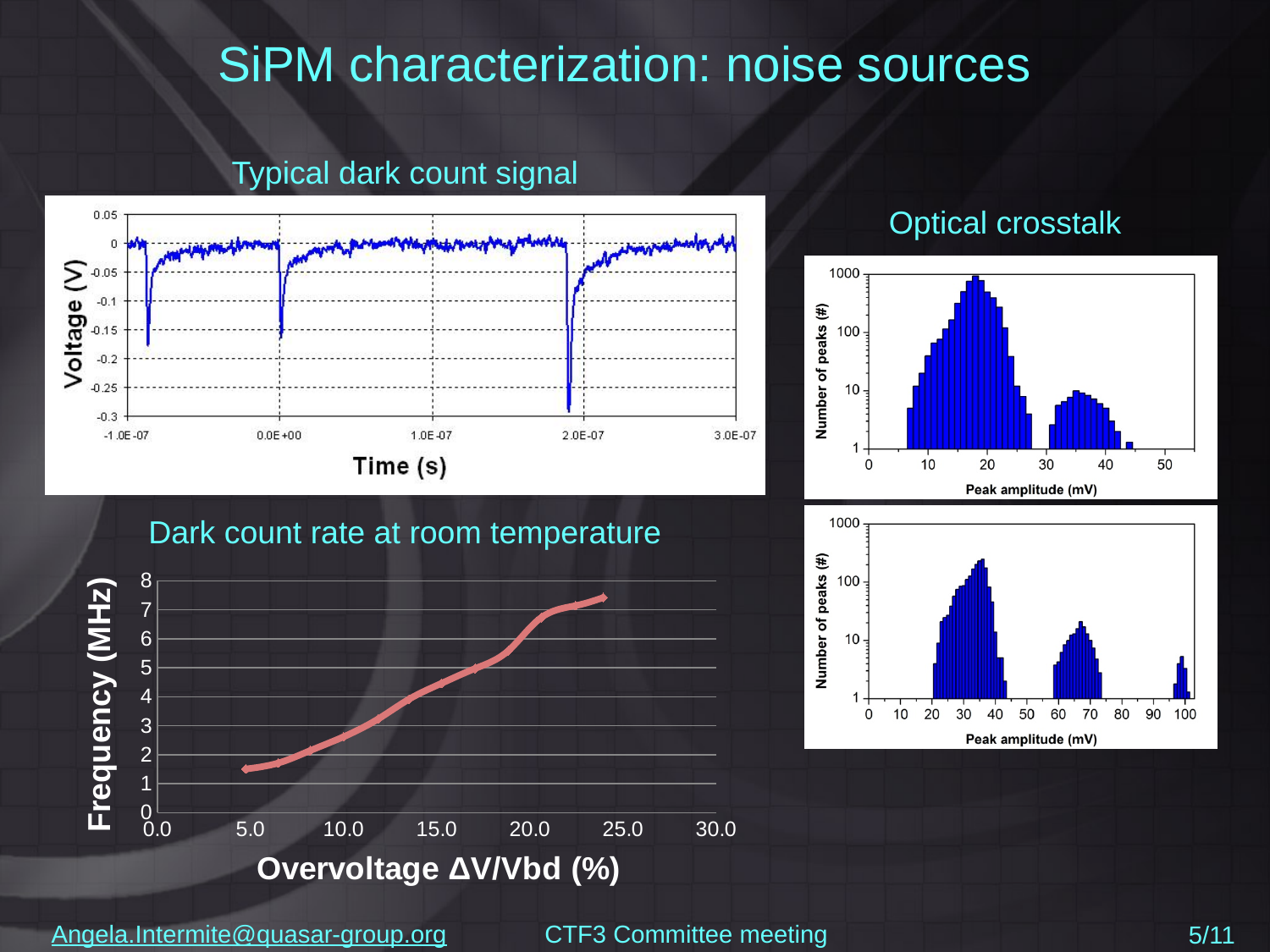
On the 'Dark count rate at room temperature' chart, is the lowest plotted frequency greater or less than 2? less On the 'Dark count rate at room temperature' chart, is the highest plotted frequency greater or less than 7? greater On the 'Dark count rate at room temperature' chart, is the frequency at an overvoltage of about 10.0 greater or less than 2? greater What kind of chart is the 'Dark count rate at room temperature' chart? line chart What is the y-axis title of the 'Dark count rate at room temperature' chart? Frequency (MHz) What kind of chart is the 'Typical dark count signal' chart? line chart What kind of chart is the upper 'Optical crosstalk' chart? bar chart On the 'Dark count rate at room temperature' chart, does the frequency rise or fall as overvoltage increases? rises On the upper 'Optical crosstalk' chart, which cluster reaches a higher number of peaks: the one around 20 mV or the one around 35 mV? the one around 20 mV What is the x-axis title of the 'Dark count rate at room temperature' chart? Overvoltage ΔV/Vbd (%)